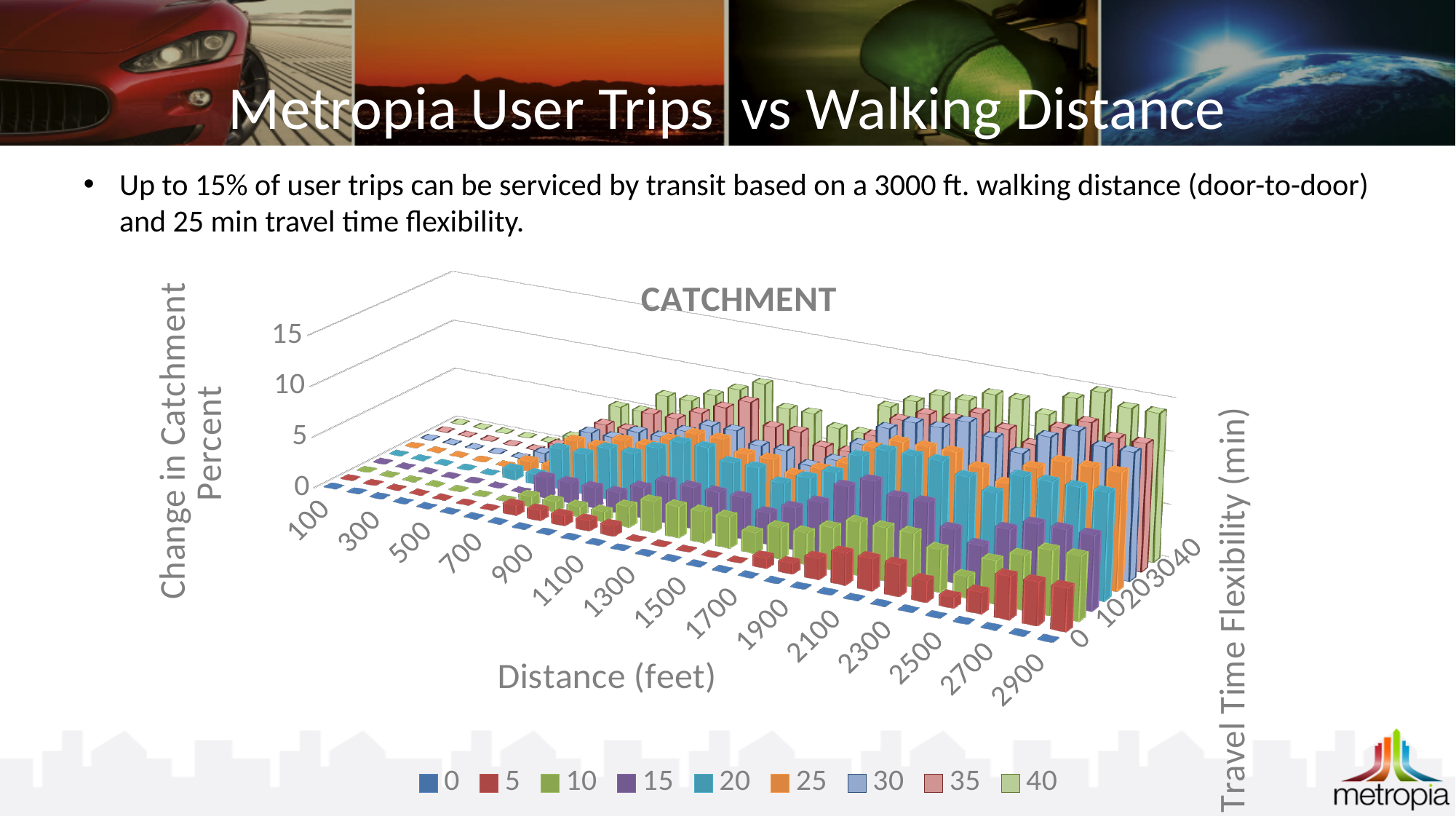
Which series has larger values at 2900 feet, the 0 series or the 40 series? 40 Is the value for the 0 travel time flexibility series at 2900 feet greater or less than 5? less What is the title of the horizontal (distance) axis of the chart? Distance (feet) What kind of chart is shown on the slide? bar chart Is the value for the 5 travel time flexibility series at 100 feet greater or less than 5? less Which series has the lowest values across all distances in the chart? 0 What is the title of the chart? CATCHMENT How many series does the chart legend list? 9 Do the values for the 40 travel time flexibility series generally rise or fall as distance increases along the x axis? rise